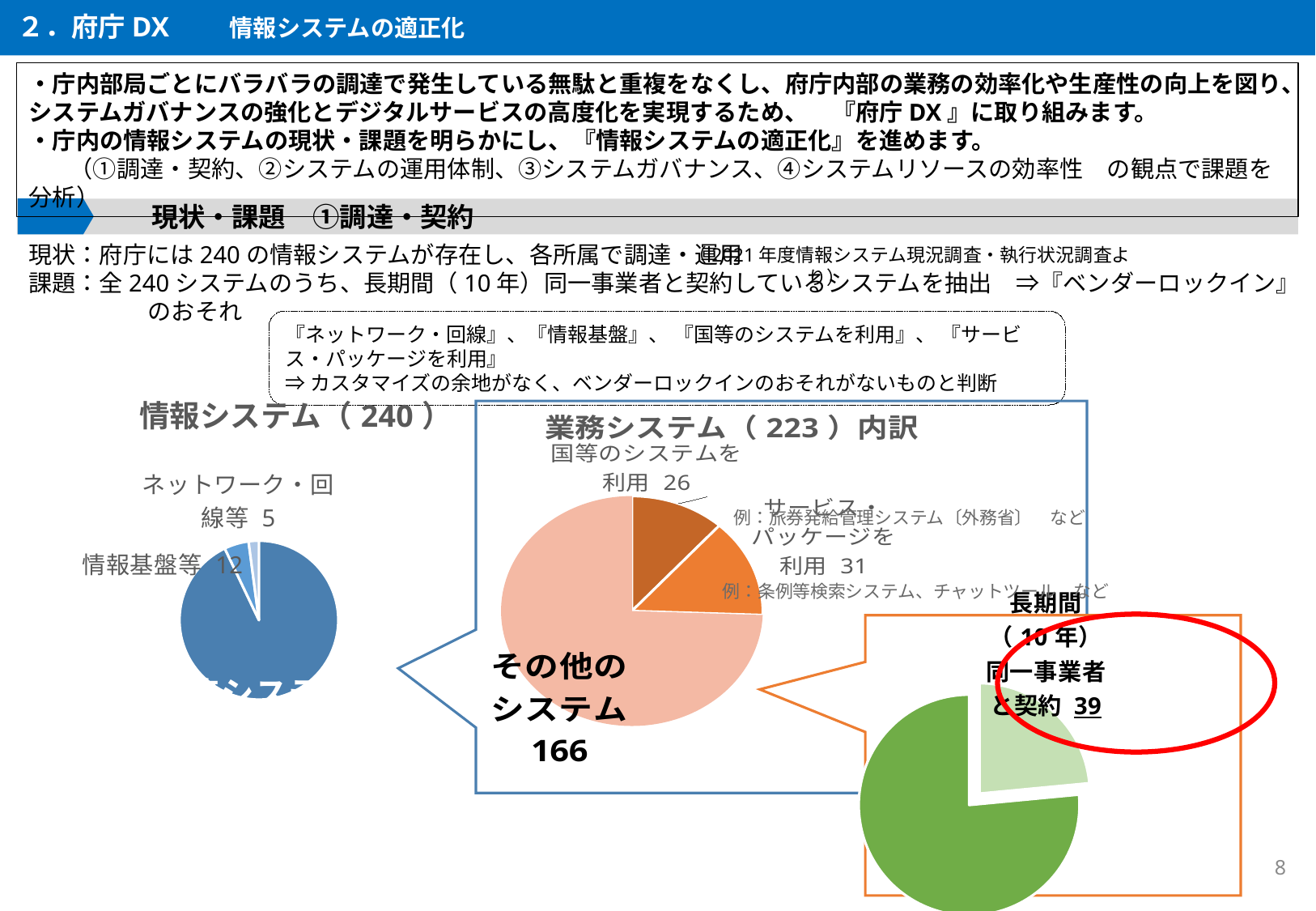
In the 情報システム（240）pie chart, which is larger, 情報基盤等 or ネットワーク・回線等? 情報基盤等 In the 業務システム（223）内訳 pie chart, what is the difference between サービス・パッケージを利用 and 国等のシステムを利用? 5 In the pie chart at the bottom right of the slide, what is the value for 長期間（10年）同一事業者と契約? 39 In the 業務システム（223）内訳 pie chart, what is the value for その他のシステム? 166 In the 業務システム（223）内訳 pie chart, which slice is the largest? その他のシステム In the 業務システム（223）内訳 pie chart, which slice is the smallest? 国等のシステムを利用 In the 情報システム（240）pie chart, what is the value for ネットワーク・回線等? 5 In the 業務システム（223）内訳 pie chart, what is the difference between その他のシステム and サービス・パッケージを利用? 135 How many slices does the 業務システム（223）内訳 pie chart have? 3 What kind of chart is the 情報システム（240）chart on the left? Pie chart In the 業務システム（223）内訳 pie chart, what is the value for サービス・パッケージを利用? 31 In the 業務システム（223）内訳 pie chart, what is the value for 国等のシステムを利用? 26